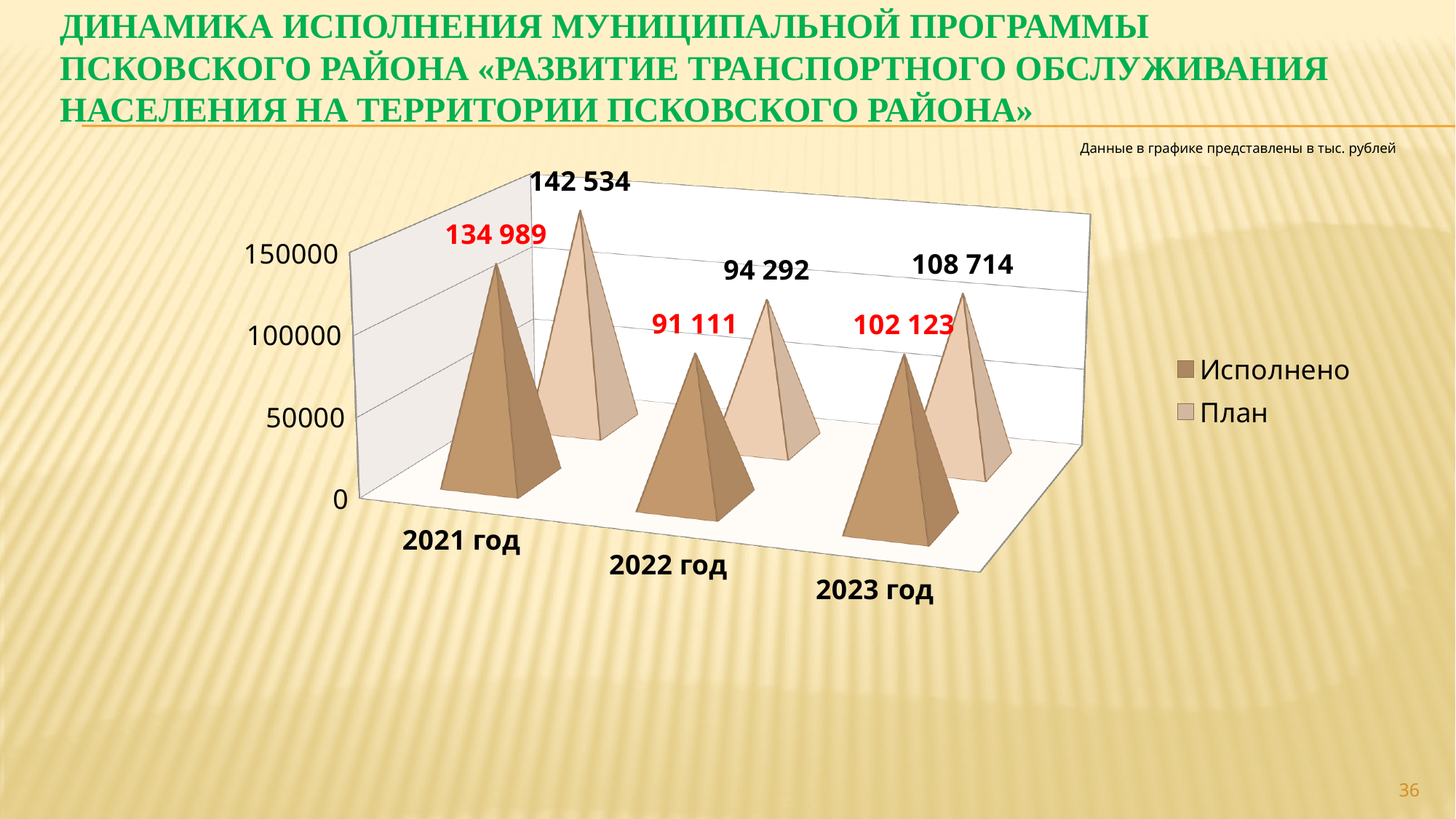
Which year has the lowest Исполнено value? 2022 год What is the difference between План and Исполнено for 2023 год? 6 591 What is the value of Исполнено for 2021 год? 134 989 In what units are the data in the chart presented, according to the note on the slide? тыс. рублей Which is larger, Исполнено for 2023 год or Исполнено for 2022 год? Исполнено for 2023 год How many years are shown on the x axis? 3 What is the value of План for 2022 год? 94 292 What is the value of План for 2023 год? 108 714 What is the difference between План and Исполнено for 2021 год? 7 545 Which year has the highest План value? 2021 год How many series does the legend list? 2 What kind of chart is shown on the slide? bar chart